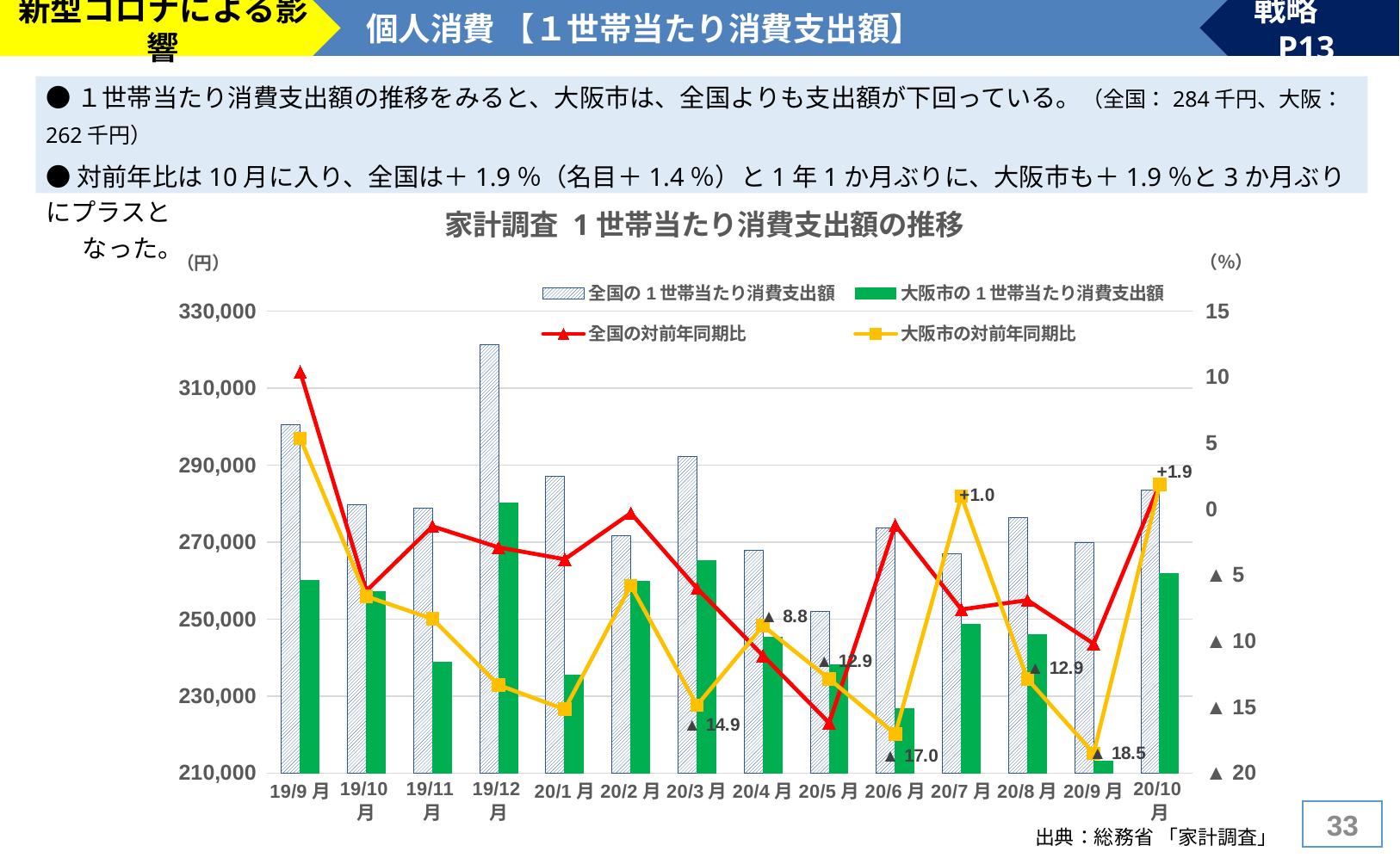
How many months are shown along the x axis of the chart? 14 Is the 大阪市の1世帯当たり消費支出額 bar for 20/9月 greater or less than 230,000? less Is the 全国の1世帯当たり消費支出額 bar for 19/12月 greater or less than 310,000? greater What is the labelled value of 大阪市の対前年同期比 for 20/9月? ▲18.5 How many series does the chart legend list? 4 What is the labelled value of 大阪市の対前年同期比 for 20/10月? +1.9 What is the title of the chart? 家計調査 1世帯当たり消費支出額の推移 What kind of chart is shown on the slide? A combination bar and line chart What is the labelled value of 大阪市の対前年同期比 for 20/7月? +1.0 In which month does the 大阪市の対前年同期比 line reach its lowest point? 20/9月 What is the labelled value of 大阪市の対前年同期比 for 20/6月? ▲17.0 In which month is the 全国の1世帯当たり消費支出額 bar the highest? 19/12月